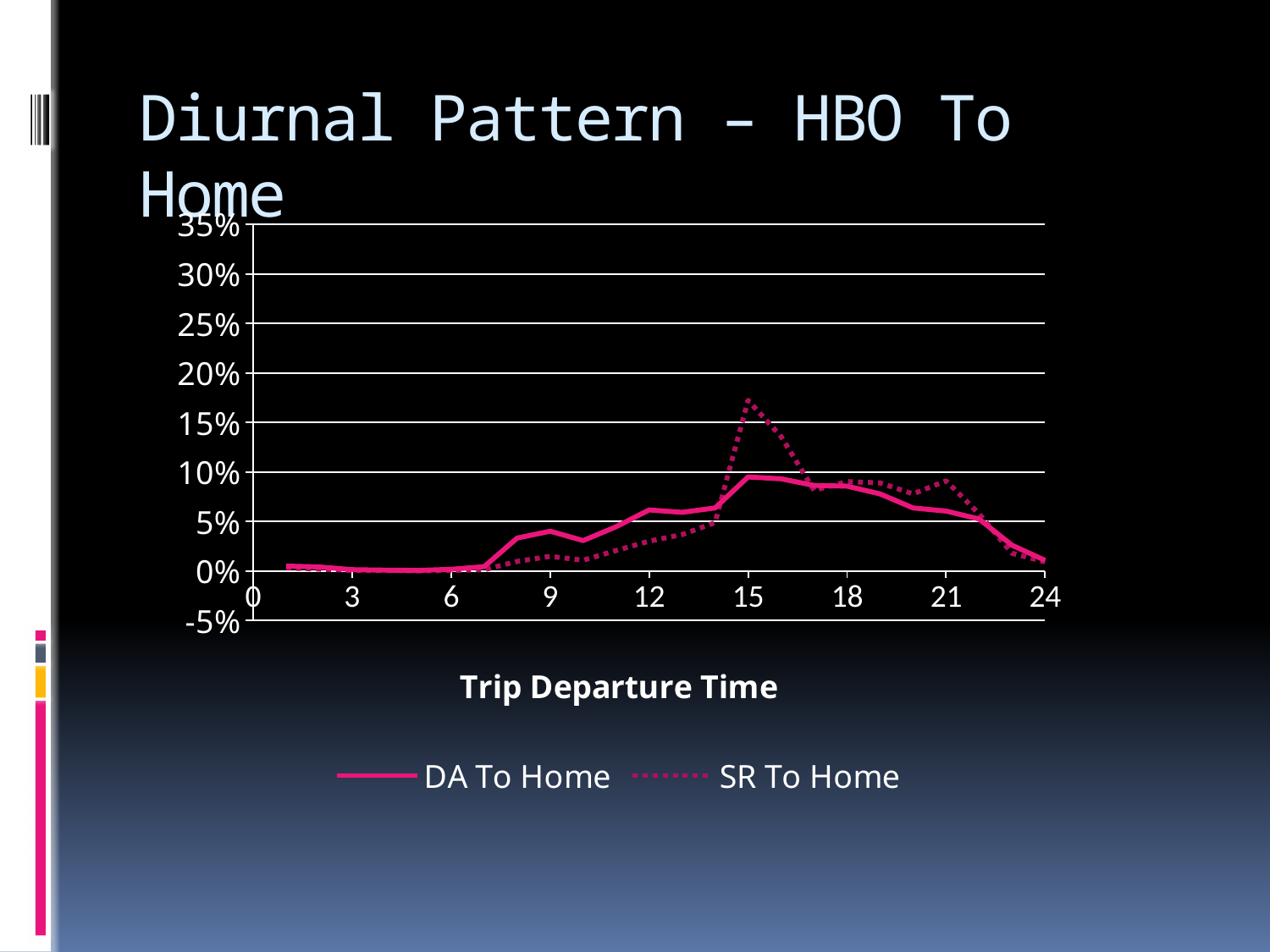
At trip departure time 12, which series has the higher value, DA To Home or SR To Home? DA To Home Is the value for SR To Home at trip departure time 9 greater or less than 5%? less What is the title of the x axis? Trip Departure Time What is the highest value shown on the y axis? 35% Is the value for SR To Home at trip departure time 15 greater or less than 15%? greater What are the two series named in the legend? DA To Home and SR To Home How many series does the legend list? 2 Is the value for DA To Home at trip departure time 15 greater or less than 5%? greater What kind of chart is shown on the slide? Line chart At trip departure time 15, which series has the higher value, DA To Home or SR To Home? SR To Home Does the DA To Home line rise or fall between trip departure times 15 and 24? Fall Which series reaches the highest value on the chart? SR To Home